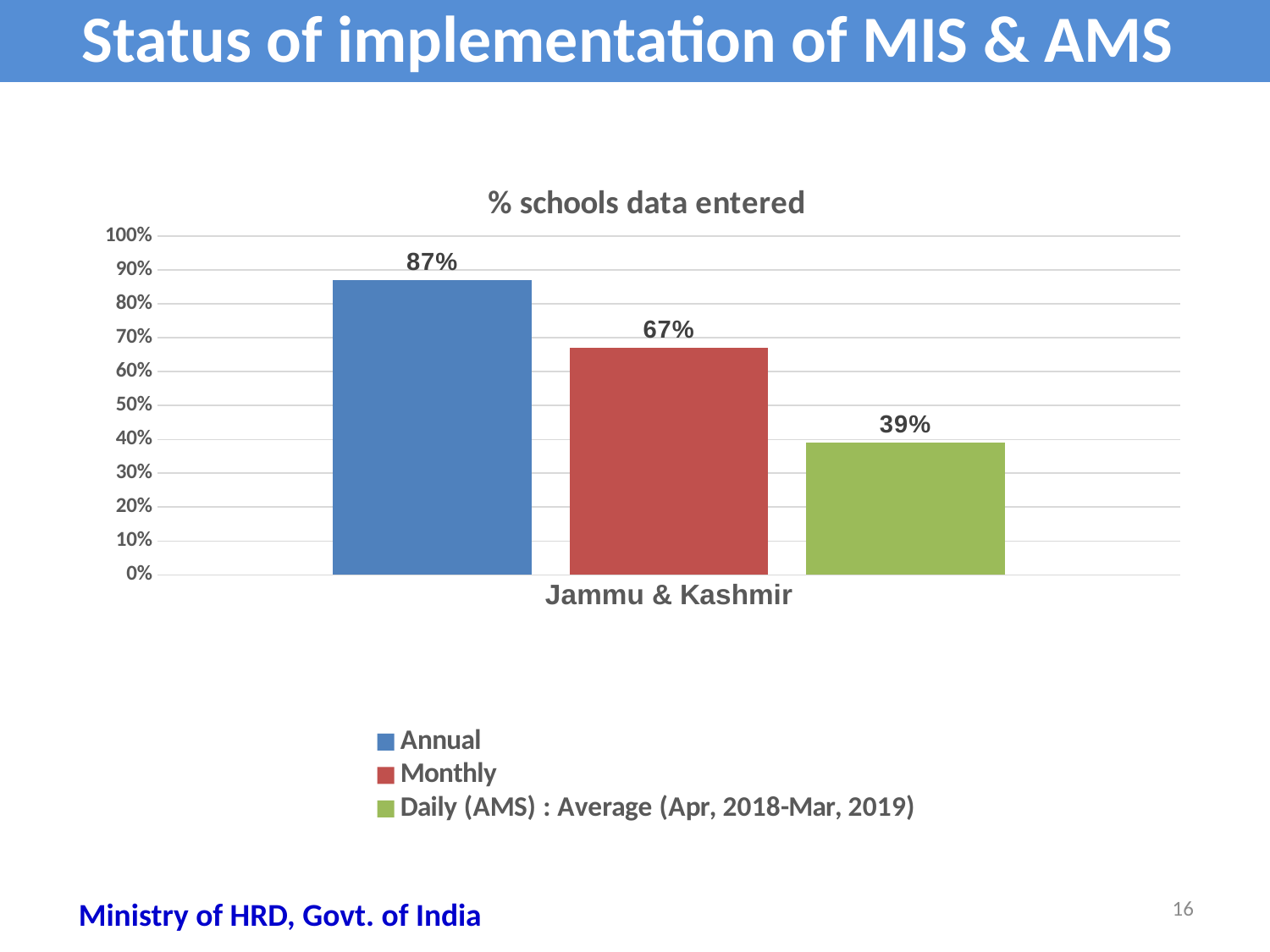
Which series has the lowest value for Jammu & Kashmir? Daily (AMS) : Average (Apr, 2018-Mar, 2019) What kind of chart is shown on the slide? Bar chart What is the Daily (AMS) : Average (Apr, 2018-Mar, 2019) value for Jammu & Kashmir? 39% What is the Annual value for Jammu & Kashmir? 87% What is the Monthly value for Jammu & Kashmir? 67% Which is larger for Jammu & Kashmir, the Monthly value or the Daily (AMS) value? Monthly How many series does the legend list? 3 What is the difference between the Annual and Monthly values for Jammu & Kashmir? 20% What is the difference between the Monthly and Daily (AMS) values for Jammu & Kashmir? 28% Is the Annual value for Jammu & Kashmir greater or less than 80%? greater Which series has the highest value for Jammu & Kashmir? Annual What is the title of the chart? % schools data entered